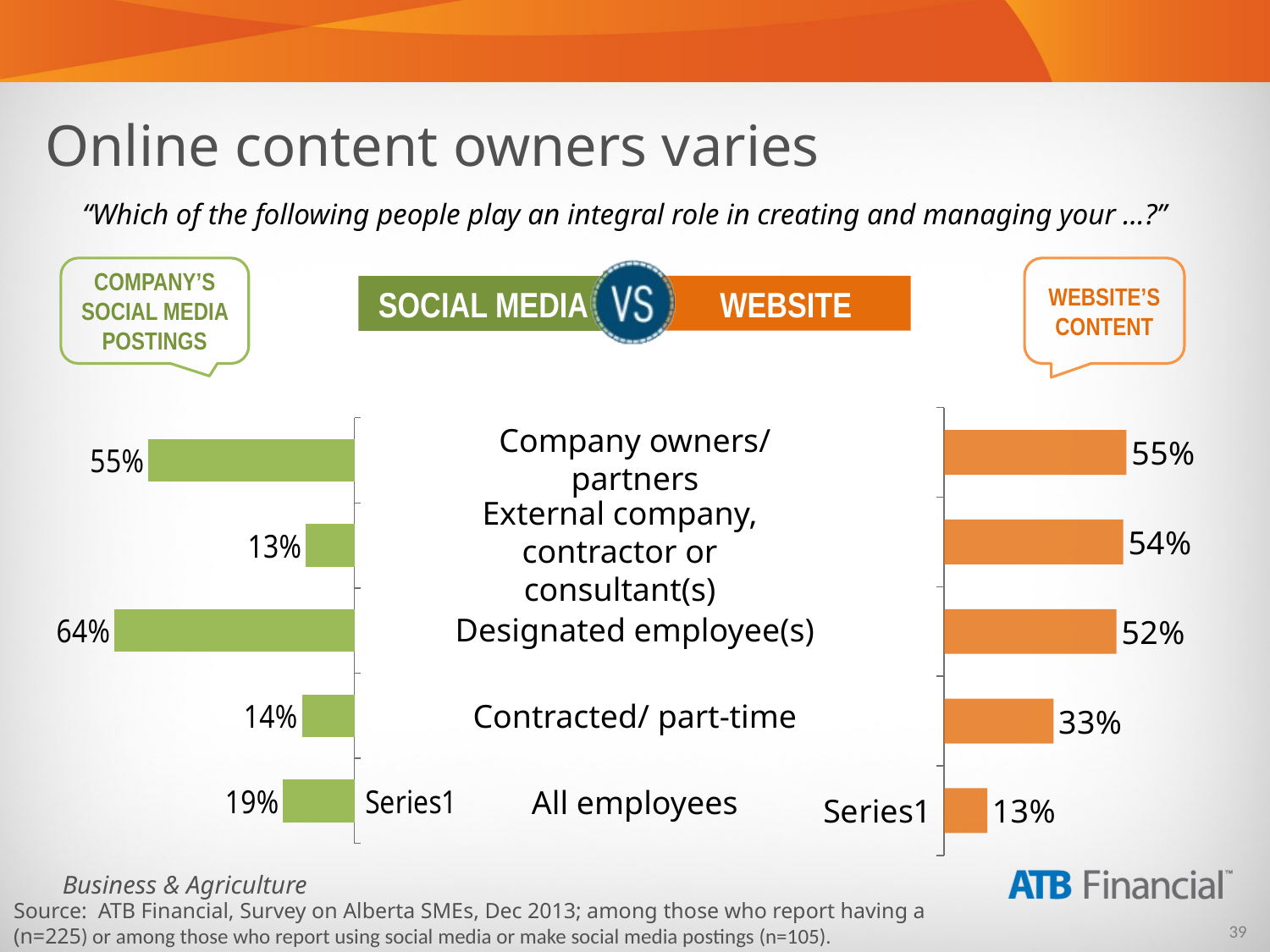
In the website's content chart (right, orange bars), what percentage is shown for Contracted/ part-time? 33% What colour are the bars in the website's content chart on the right? Orange What type of chart is used for the social media postings data on the left? Bar chart For External company, contractor or consultant(s), which chart shows the larger value: social media postings or website's content? Website's content In the website's content chart (right, orange bars), which category has the lowest value? All employees In the website's content chart (right, orange bars), what percentage is shown for External company, contractor or consultant(s)? 54% In the social media postings chart (left, green bars), which category has the lowest value? External company, contractor or consultant(s) In the social media postings chart (left, green bars), which category has the highest value? Designated employee(s) In the social media postings chart (left, green bars), what percentage is shown for All employees? 19% How many categories are shown in the website's content chart (right, orange bars)? 5 What is the difference between the Designated employee(s) value in the social media postings chart (64%) and in the website's content chart (52%)? 12 percentage points In the social media postings chart (left, green bars), what percentage is shown for Designated employee(s)? 64%